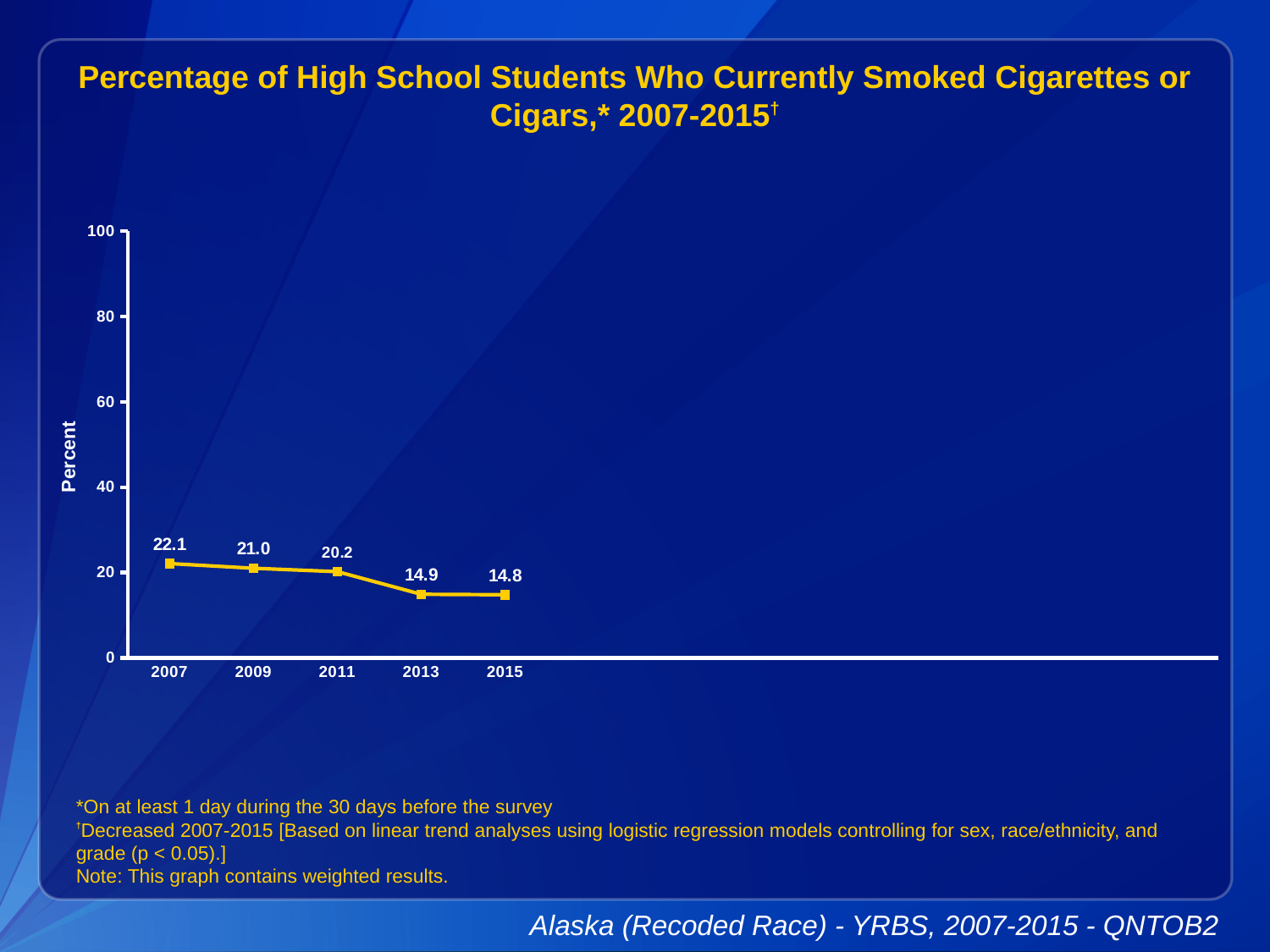
Is the value for 2007 greater or less than 20? greater What is the difference between the 2011 and 2013 percentages? 5.3 What is the difference between the 2007 and 2015 percentages? 7.3 Which year had the lowest percentage of students who currently smoked cigarettes or cigars? 2015 What was the percentage of high school students who currently smoked cigarettes or cigars in 2011? 20.2 How many years are plotted on the chart? 5 Which year had a higher percentage, 2009 or 2013? 2009 What was the percentage of high school students who currently smoked cigarettes or cigars in 2015? 14.8 Do the values rise or fall from 2007 to 2015? fall What was the percentage of high school students who currently smoked cigarettes or cigars in 2007? 22.1 What kind of chart is shown on the slide? line chart Which year had the highest percentage of students who currently smoked cigarettes or cigars? 2007